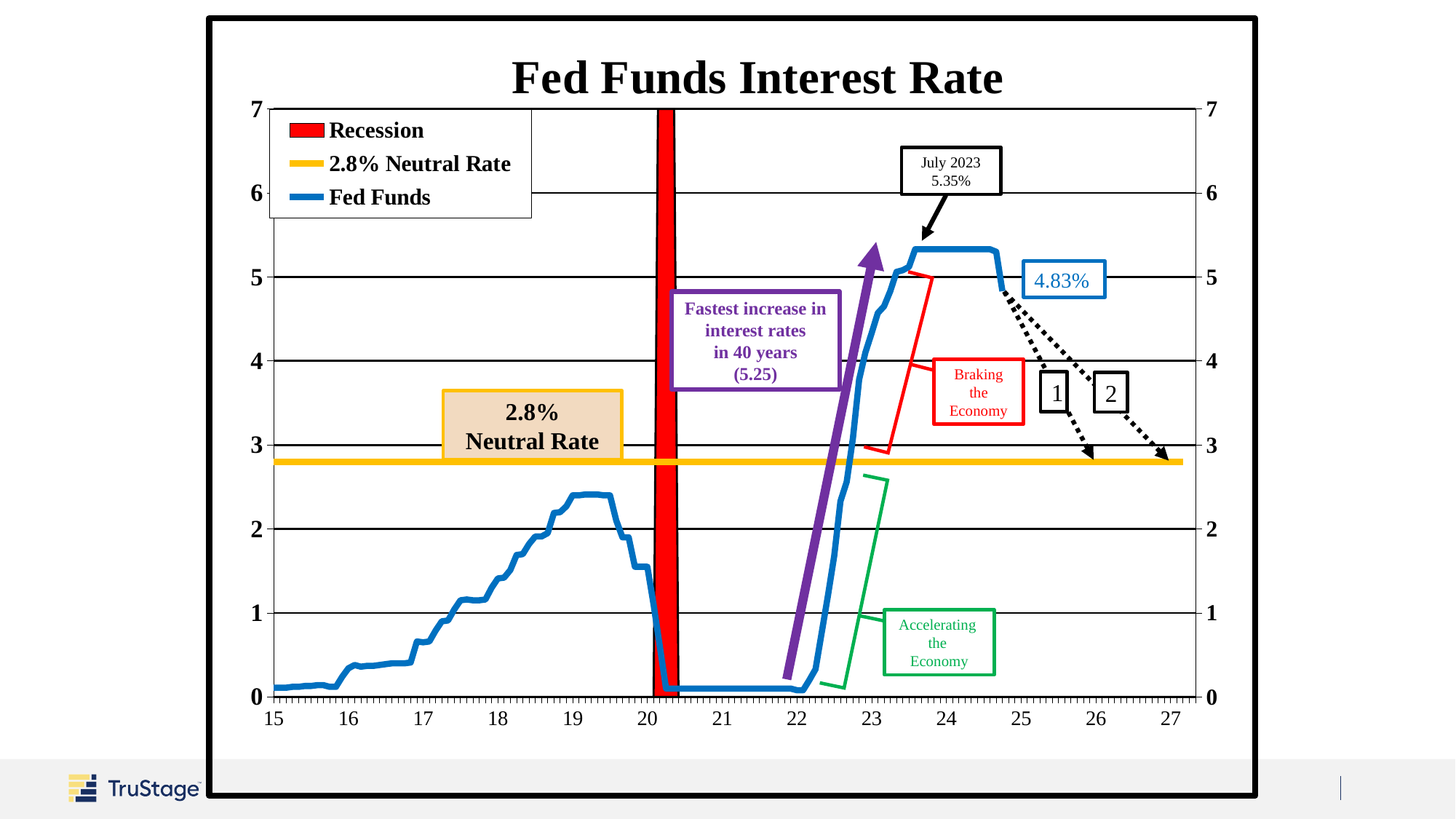
Is the Fed Funds rate at the start of 2024 greater or less than 5? greater What is the value of the neutral rate shown on the chart? 2.8% Is the Fed Funds rate during 2021 greater or less than 1? less What Fed Funds rate is labeled for July 2023? 5.35% Which is larger, the July 2023 Fed Funds rate or the neutral rate? July 2023 Fed Funds rate Does the Fed Funds rate rise or fall between mid-2019 and mid-2020? fall What is the title of the chart? Fed Funds Interest Rate What kind of chart is shown on the slide? line chart Does the Fed Funds rate rise or fall between 2022 and 2023? rise How many entries does the chart's legend list? 3 What colour is the Fed Funds line on the chart? blue What is the most recent Fed Funds rate labeled on the chart, near 2025? 4.83%